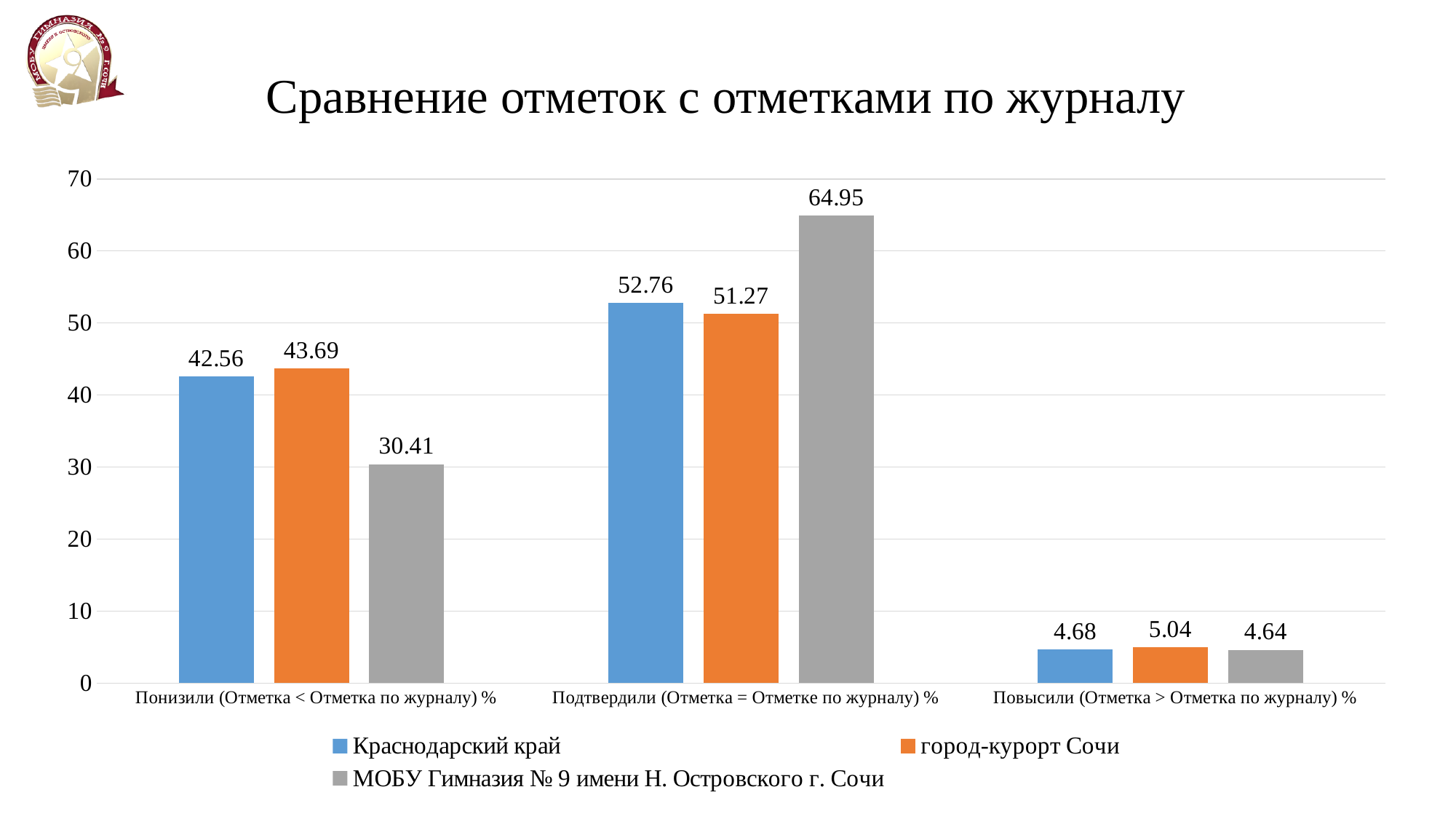
What is the value for город-курорт Сочи in the category Повысили (Отметка > Отметка по журналу) %? 5.04 Which series has the lowest value in the category Понизили (Отметка < Отметка по журналу) %? МОБУ Гимназия № 9 имени Н. Островского г. Сочи What is the value for МОБУ Гимназия № 9 имени Н. Островского г. Сочи in the category Понизили (Отметка < Отметка по журналу) %? 30.41 Which series has the highest value in the category Подтвердили (Отметка = Отметке по журналу) %? МОБУ Гимназия № 9 имени Н. Островского г. Сочи How many categories are shown on the x axis of the chart? 3 What is the difference between the МОБУ Гимназия № 9 value and the Краснодарский край value in the category Подтвердили (Отметка = Отметке по журналу) %? 12.19 Is the value for МОБУ Гимназия № 9 in the category Подтвердили (Отметка = Отметке по журналу) % greater or less than 60? greater What kind of chart is shown on the slide? bar chart In the category Повысили (Отметка > Отметка по журналу) %, which is larger: the value for Краснодарский край or the value for город-курорт Сочи? город-курорт Сочи What is the difference between the город-курорт Сочи value and the МОБУ Гимназия № 9 value in the category Понизили (Отметка < Отметка по журналу) %? 13.28 How many series does the legend list? 3 What is the value for Краснодарский край in the category Подтвердили (Отметка = Отметке по журналу) %? 52.76